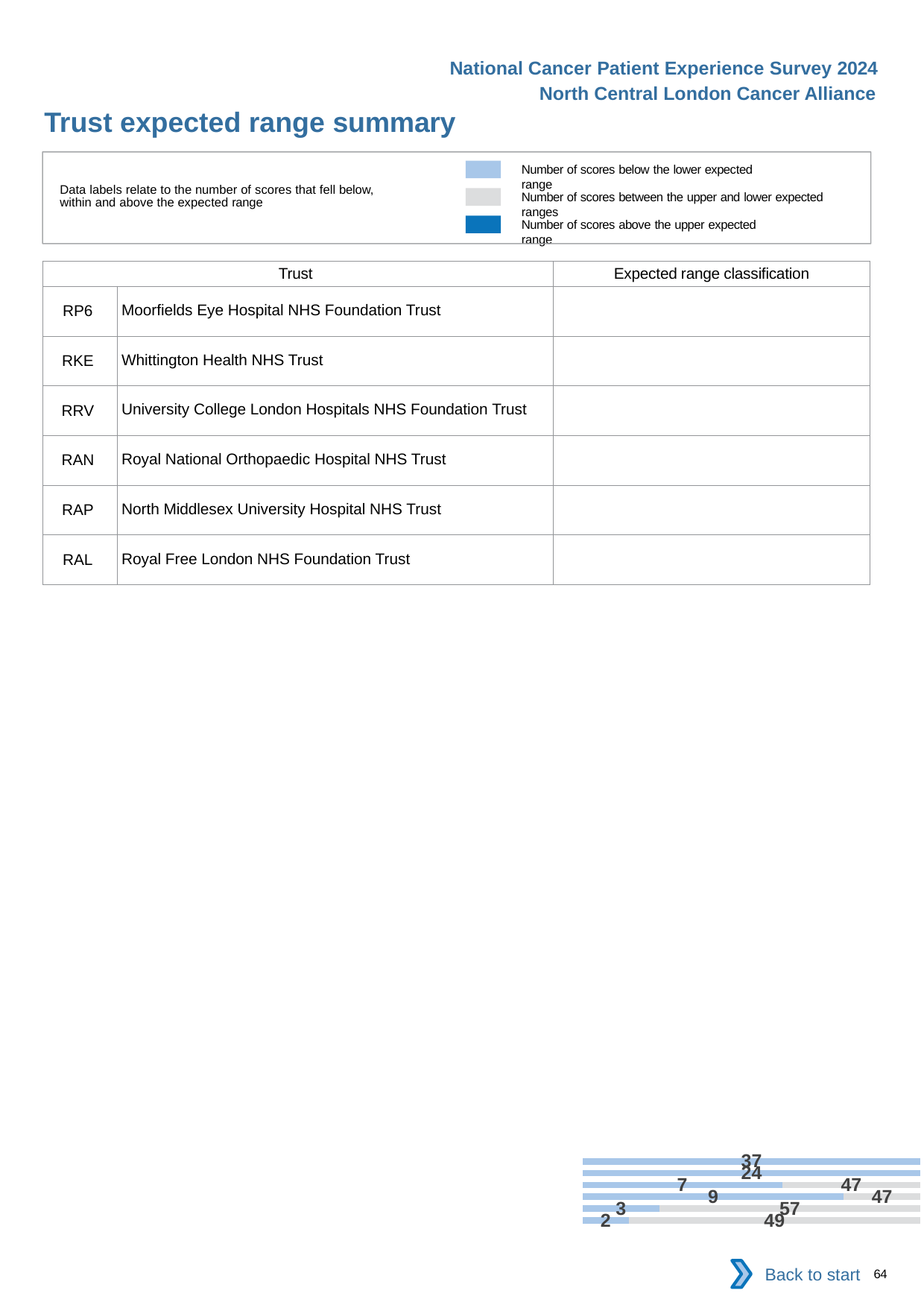
How many bars are plotted in the chart at the bottom right of the slide? 6 In the chart at the bottom right, what is the value labelled on the grey segment of the bottom bar? 49 In the chart at the bottom right, what is the difference between the grey segment (49) and the light blue segment (2) of the bottom bar? 47 According to the key, what does the light blue colour represent? Number of scores below the lower expected range According to the key, what does the grey colour represent? Number of scores between the upper and lower expected ranges In the chart at the bottom right, what is the value labelled on the topmost bar? 37 What kind of chart is shown at the bottom right of the slide? bar chart How many entries does the colour key at the top of the slide list? 3 In the chart at the bottom right, which is larger in the bottom bar: the light blue segment (2) or the grey segment (49)? grey segment (49) In the chart at the bottom right, what is the value labelled on the light blue segment of the bottom bar? 2